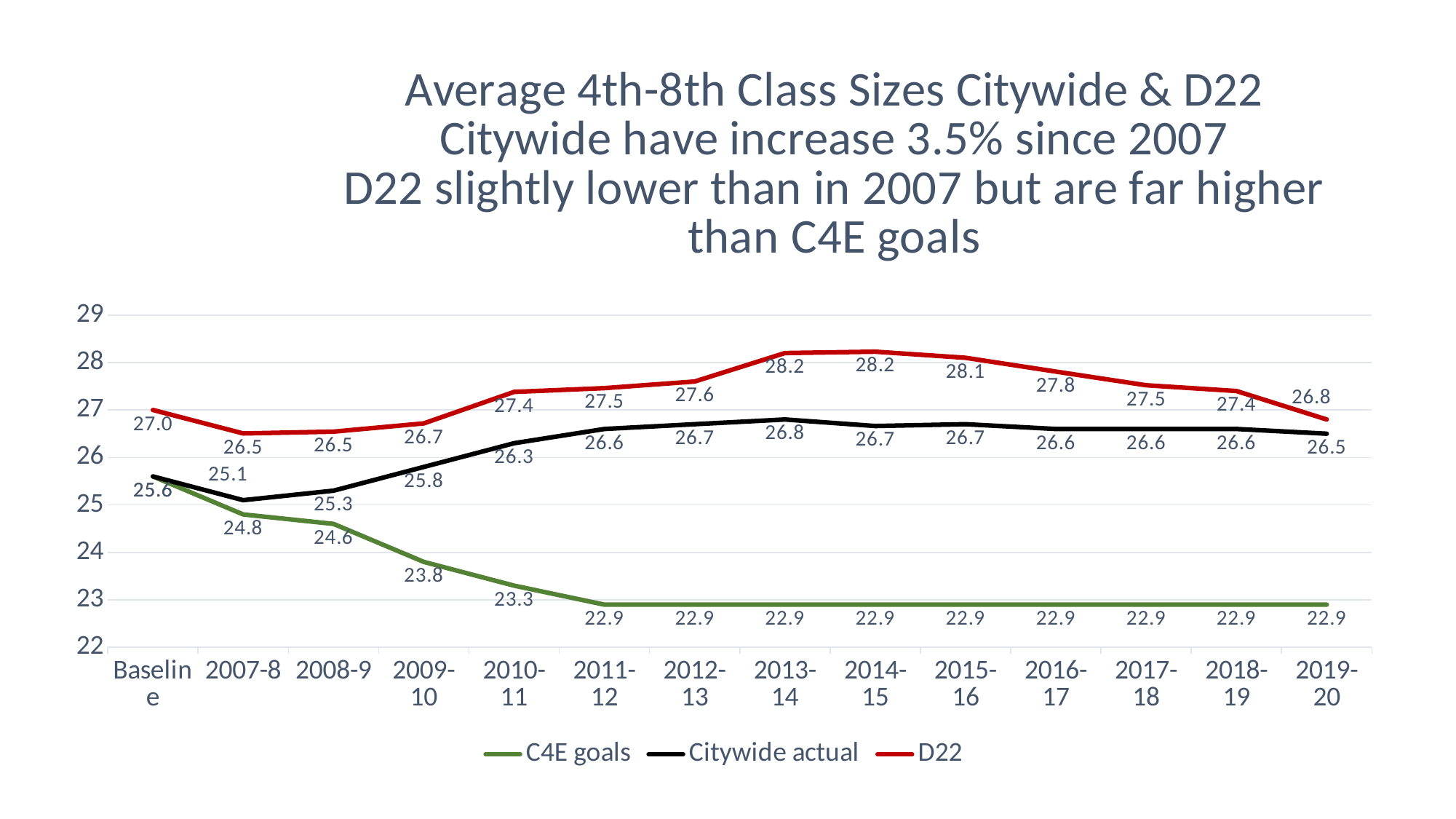
What is the C4E goals value for 2009-10? 23.8 How many series does the legend list? 3 How many points are plotted along the x axis for each series? 14 In which year is the Citywide actual value lowest? 2007-8 What is the Citywide actual value for 2019-20? 26.5 What is the difference between the D22 value and the Citywide actual value in 2019-20? 0.3 What kind of chart is shown on the slide? line chart What is the D22 value for 2013-14? 28.2 How much did the D22 value fall from 2013-14 to 2019-20? 1.4 Do the C4E goals values rise or fall from Baseline to 2011-12? fall Is the D22 value for 2014-15 greater or less than 28? greater In 2010-11, which is larger: Citywide actual or D22? D22